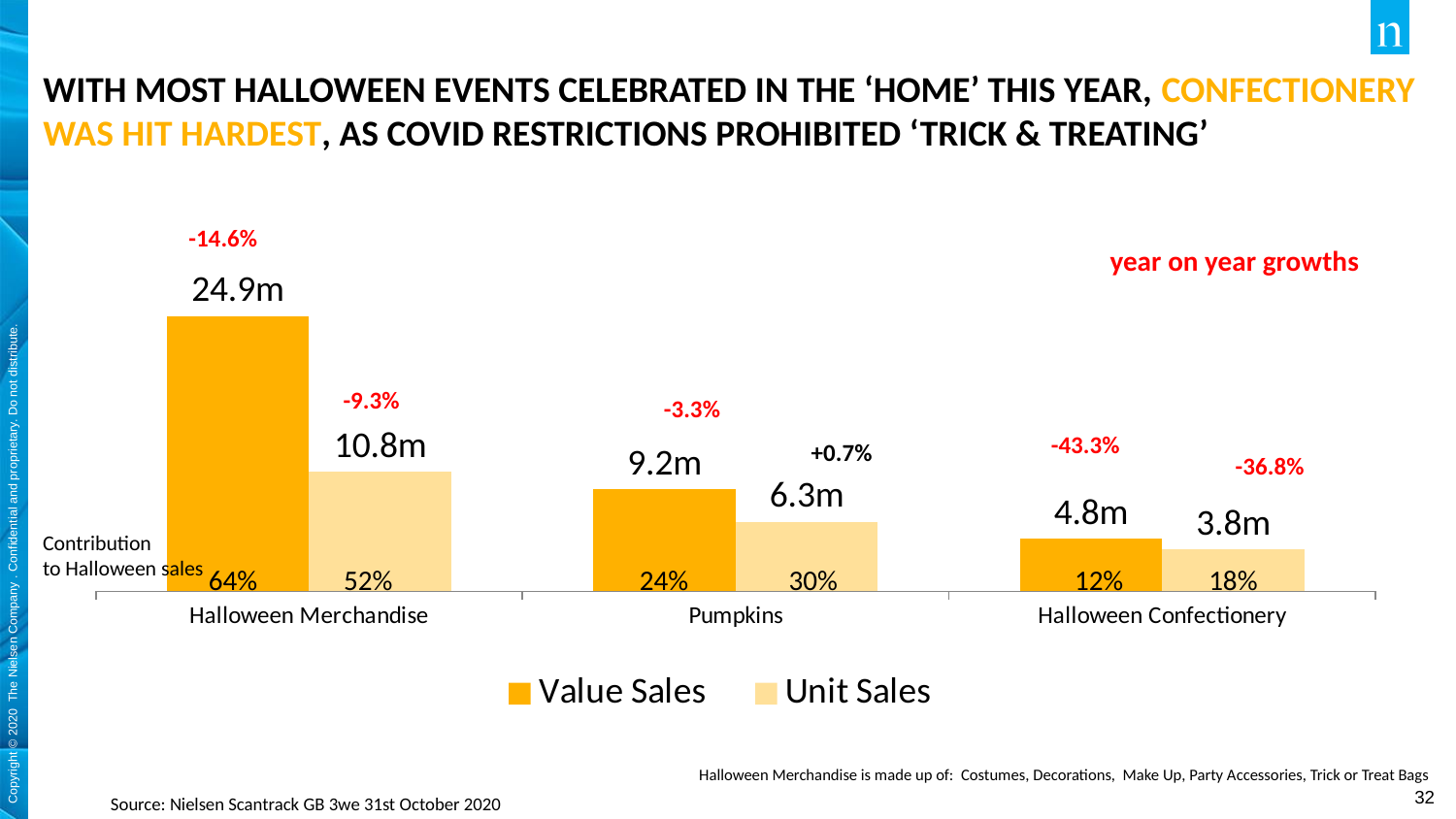
What is the Value Sales figure for Halloween Merchandise? 24.9m What contribution to Halloween sales is shown for Unit Sales of Halloween Merchandise? 52% What is the difference between Value Sales and Unit Sales for Halloween Merchandise? 14.1m How many series does the chart legend list? 2 What is the year on year growth shown for Value Sales of Halloween Confectionery? -43.3% How many categories are shown on the x axis of the chart? 3 What is the Unit Sales figure for Pumpkins? 6.3m Which category has the highest Value Sales? Halloween Merchandise Which category has the lowest Unit Sales? Halloween Confectionery What is the difference in Value Sales between Halloween Merchandise and Halloween Confectionery? 20.1m Which is larger, Value Sales for Pumpkins or Unit Sales for Halloween Merchandise? Unit Sales for Halloween Merchandise What kind of chart is shown on the slide? Bar chart